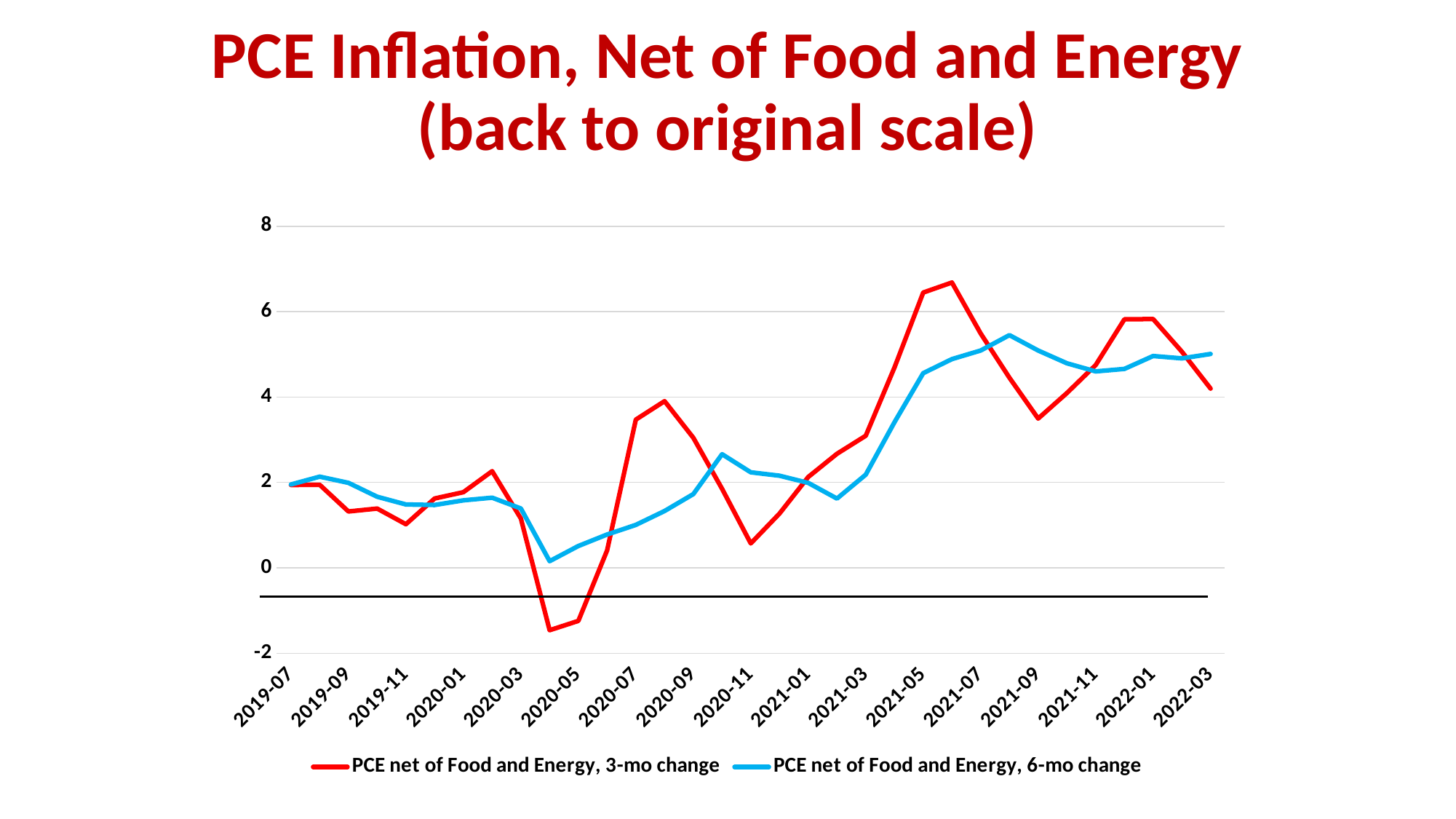
What is the title of the chart? PCE Inflation, Net of Food and Energy (back to original scale) Is the value of the 3-mo change series at 2021-09 greater or less than 4? less At 2022-03, which series has the higher value, the 3-mo change or the 6-mo change? 6-mo change How many date labels are shown on the x axis? 17 How many series does the legend list? 2 Is the value of the 6-mo change series at 2021-07 greater or less than 6? less What kind of chart is shown on the slide? line chart At 2021-05, which series has the higher value, the 3-mo change or the 6-mo change? 3-mo change Is the value of the 3-mo change series at 2021-05 greater or less than 6? greater Which colour is used for the 'PCE net of Food and Energy, 6-mo change' series? blue